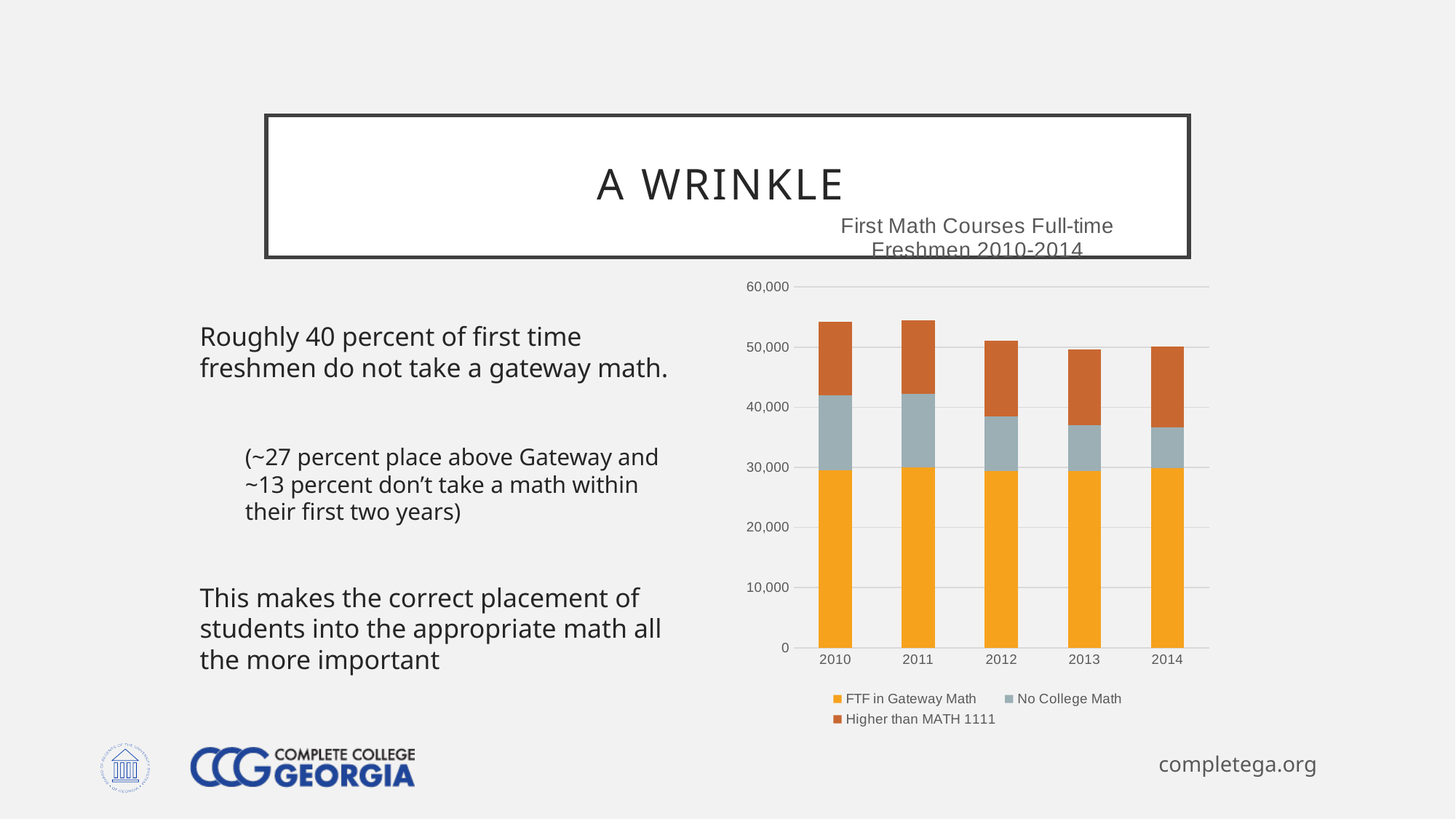
Is the total bar height for 2013 greater or less than 40,000? greater Is the total bar height for 2011 greater or less than 60,000? less How many years are shown on the x axis of the chart? 5 Do the total bar heights generally rise or fall from 2010 to 2014? fall Which year has the larger total bar, 2011 or 2014? 2011 Is the FTF in Gateway Math value for 2010 greater or less than 20,000? greater How many series does the chart's legend list? 3 Which series is shown at the bottom of each stacked bar? FTF in Gateway Math What is the title of the chart? First Math Courses Full-time Freshmen 2010-2014 Which year has the larger total bar, 2010 or 2013? 2010 What type of chart is shown on the slide? Stacked bar chart